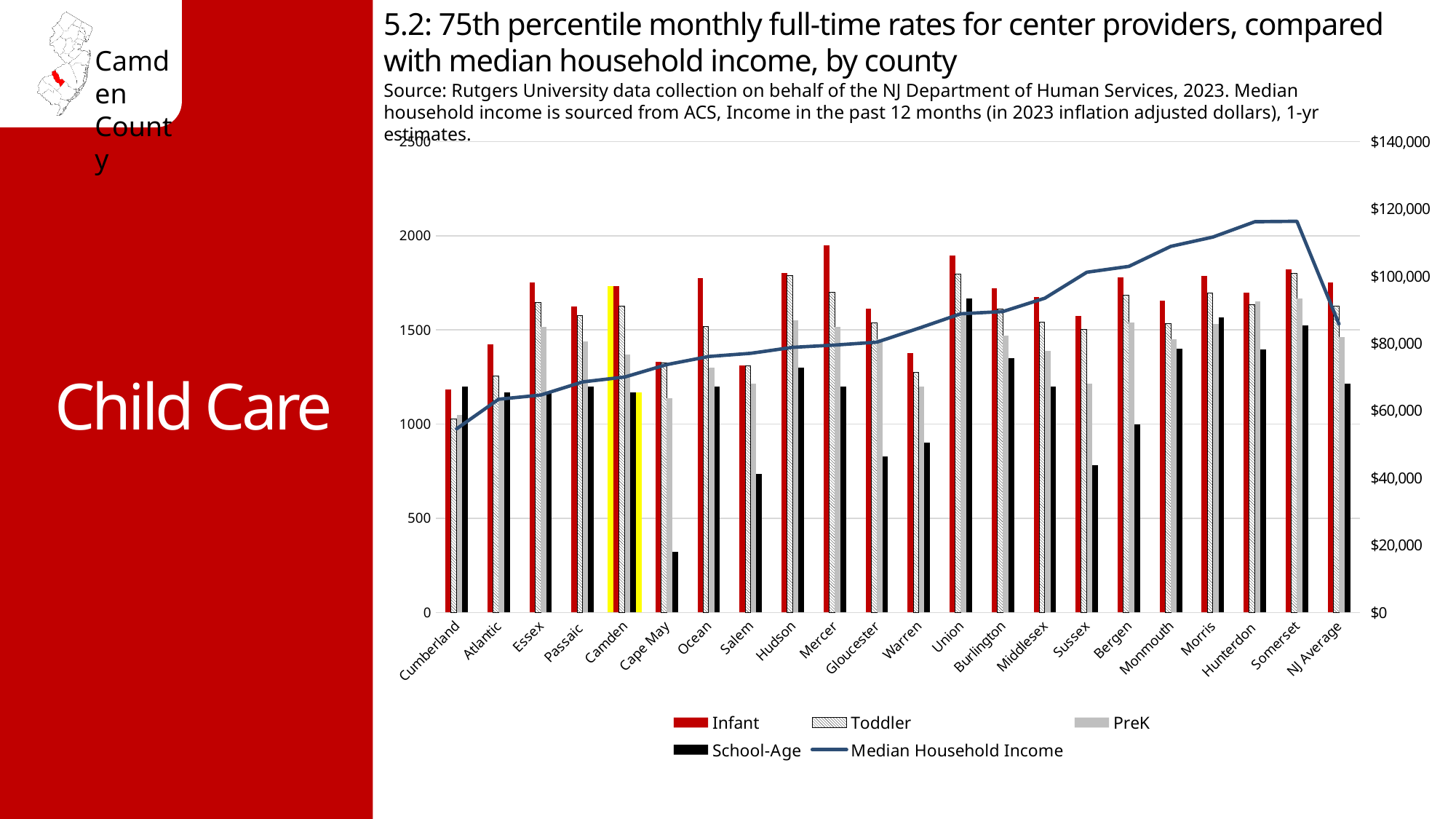
What kind of chart is shown on the slide? Bar chart with a line Is the Infant value for Camden greater or less than 1500? greater How many counties/categories are shown along the x axis? 22 Does the Median Household Income line generally rise or fall from Cumberland to Somerset? rise Which county has the lowest School-Age rate? Cape May Is the School-Age value for Cape May greater or less than 500? less Which county's bars are highlighted in yellow? Camden How many series does the legend list? 5 Which county has the highest Infant rate? Mercer Which county has the lowest Infant rate? Cumberland Is the Median Household Income for Somerset greater or less than $100,000? greater Which is larger, the School-Age value for Salem or for Cape May? Salem